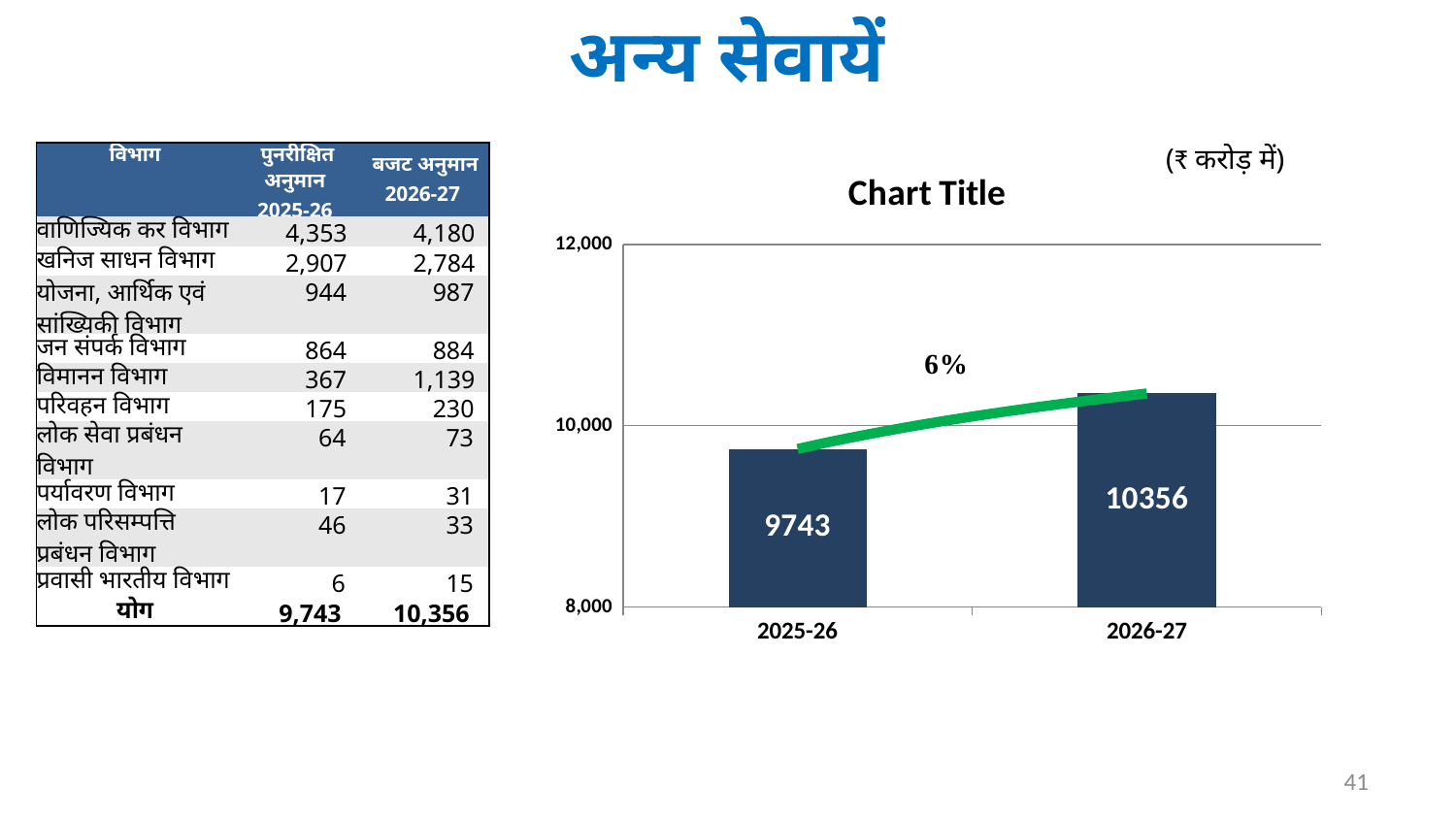
What is the value for 2026-27 in the chart? 10356 Which year has the lower value in the chart? 2025-26 What type of chart is shown on the slide? bar chart What percentage change is annotated between the two bars in the chart? 6% What is the value for 2025-26 in the chart? 9743 Do the values rise or fall from 2025-26 to 2026-27? rise Is the value for 2026-27 greater or less than 10,000? greater Is the value for 2025-26 greater or less than 10,000? less What is the title shown above the chart? Chart Title What is the difference between the values for 2026-27 and 2025-26 in the chart? 613 Which year has the higher value in the chart? 2026-27 How many bars are plotted in the chart? 2